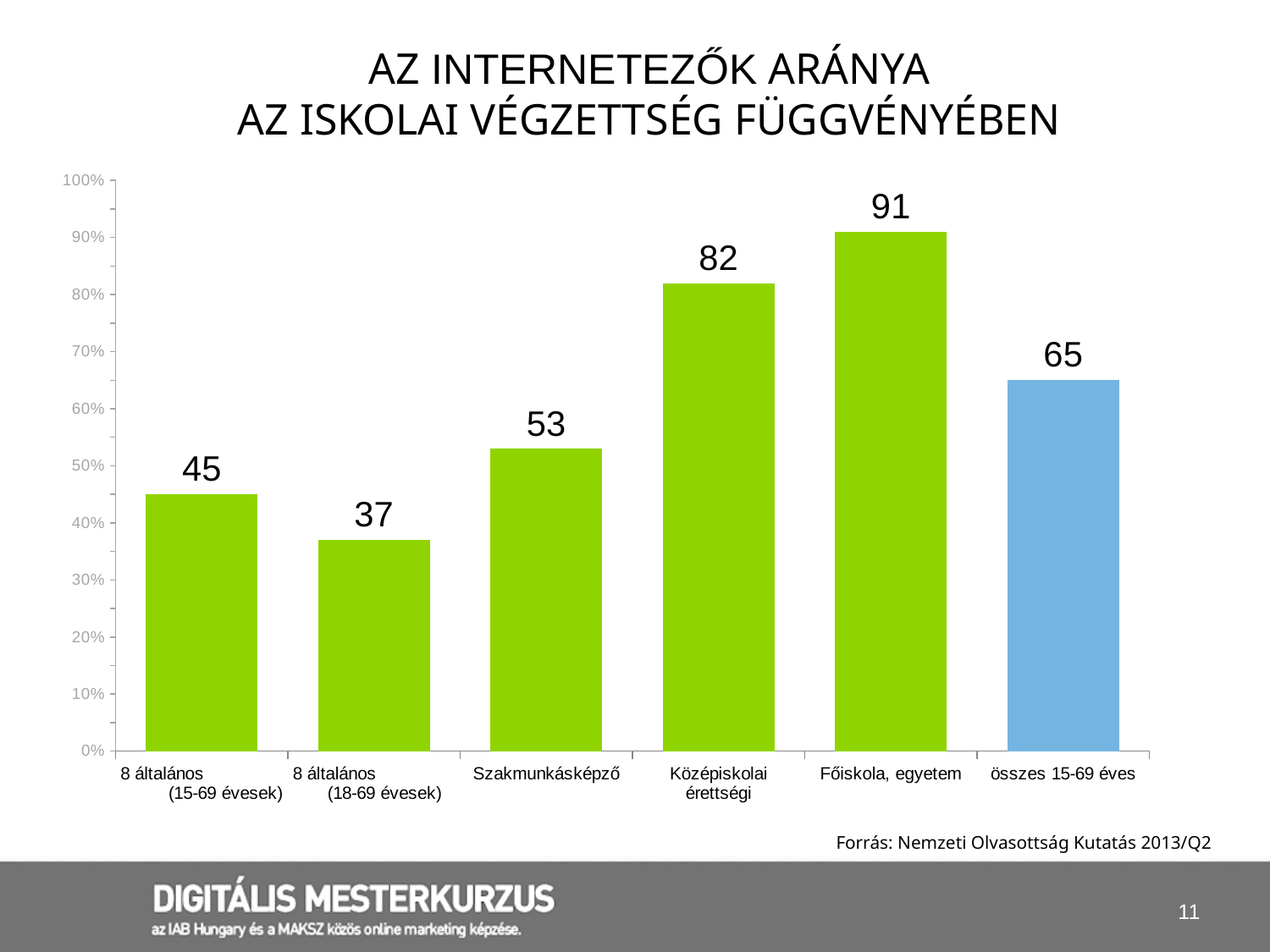
What is the value for Főiskola, egyetem? 91 Which is larger, the value for Középiskolai érettségi or the value for összes 15-69 éves? Középiskolai érettségi Which category has the highest value? Főiskola, egyetem Is the value for Szakmunkásképző greater or less than 50%? greater What is the difference between the values for 8 általános (15-69 évesek) and 8 általános (18-69 évesek)? 8 What is the value for összes 15-69 éves? 65 What is the difference between the values for Főiskola, egyetem and Középiskolai érettségi? 9 How many categories are shown on the x axis? 6 Which category has the lowest value? 8 általános (18-69 évesek) What is the title of the chart? AZ INTERNETEZŐK ARÁNYA AZ ISKOLAI VÉGZETTSÉG FÜGGVÉNYÉBEN What is the value for Szakmunkásképző? 53 What kind of chart is shown on the slide? bar chart